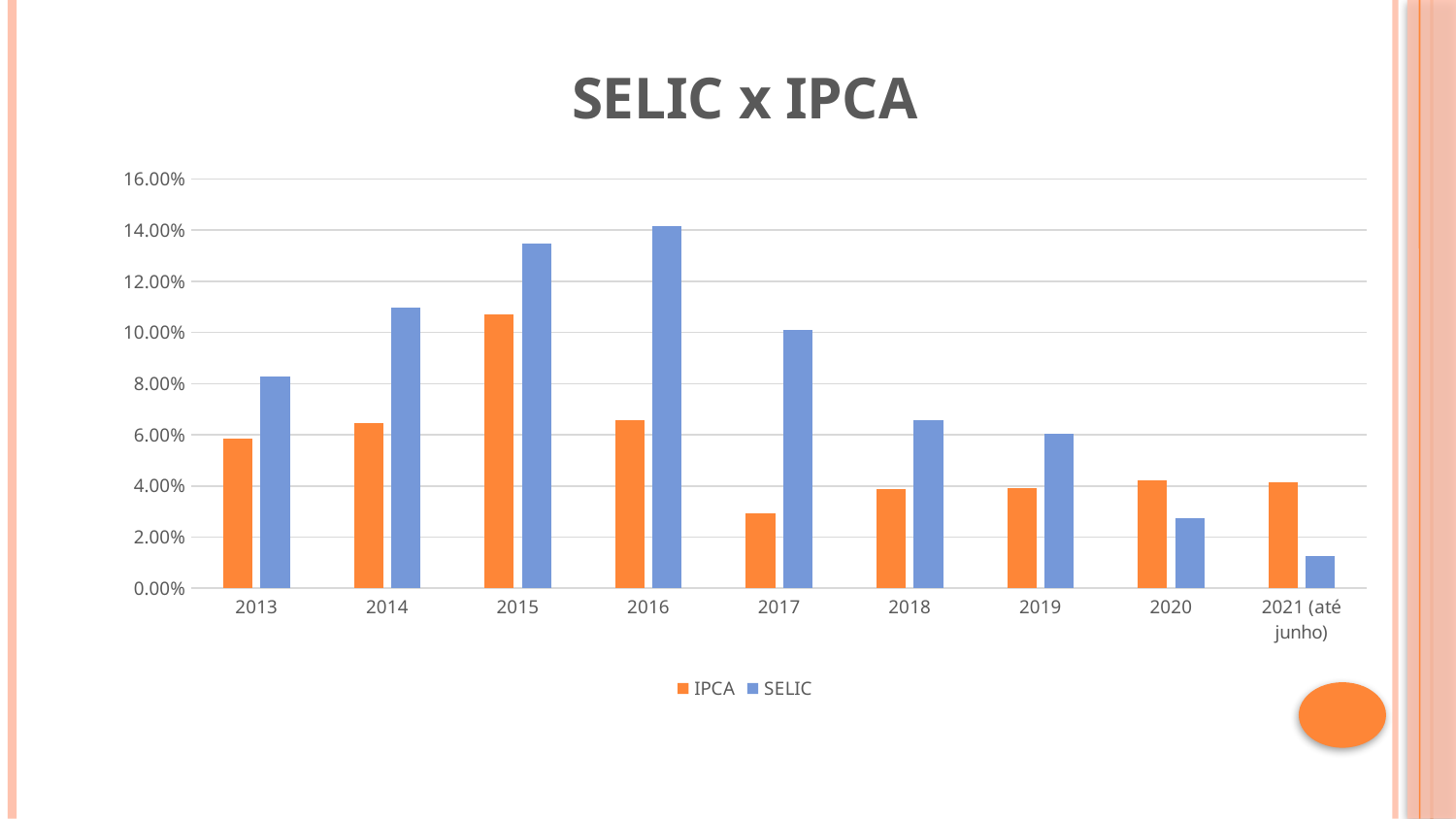
Is the SELIC value for 2015 greater or less than 12.00%? greater In which year is the IPCA value lowest? 2017 Is the IPCA value for 2017 greater or less than 4.00%? less In which category is the SELIC value lowest? 2021 (até junho) Does the SELIC value rise or fall from 2016 to 2021 (até junho)? fall What kind of chart is shown on the slide? bar chart In 2020, which is larger, IPCA or SELIC? IPCA How many year categories are shown on the x axis? 9 How many series does the legend list? 2 In which year is the SELIC value highest? 2016 Is the SELIC value for 2020 greater or less than 4.00%? less In which year is the IPCA value highest? 2015